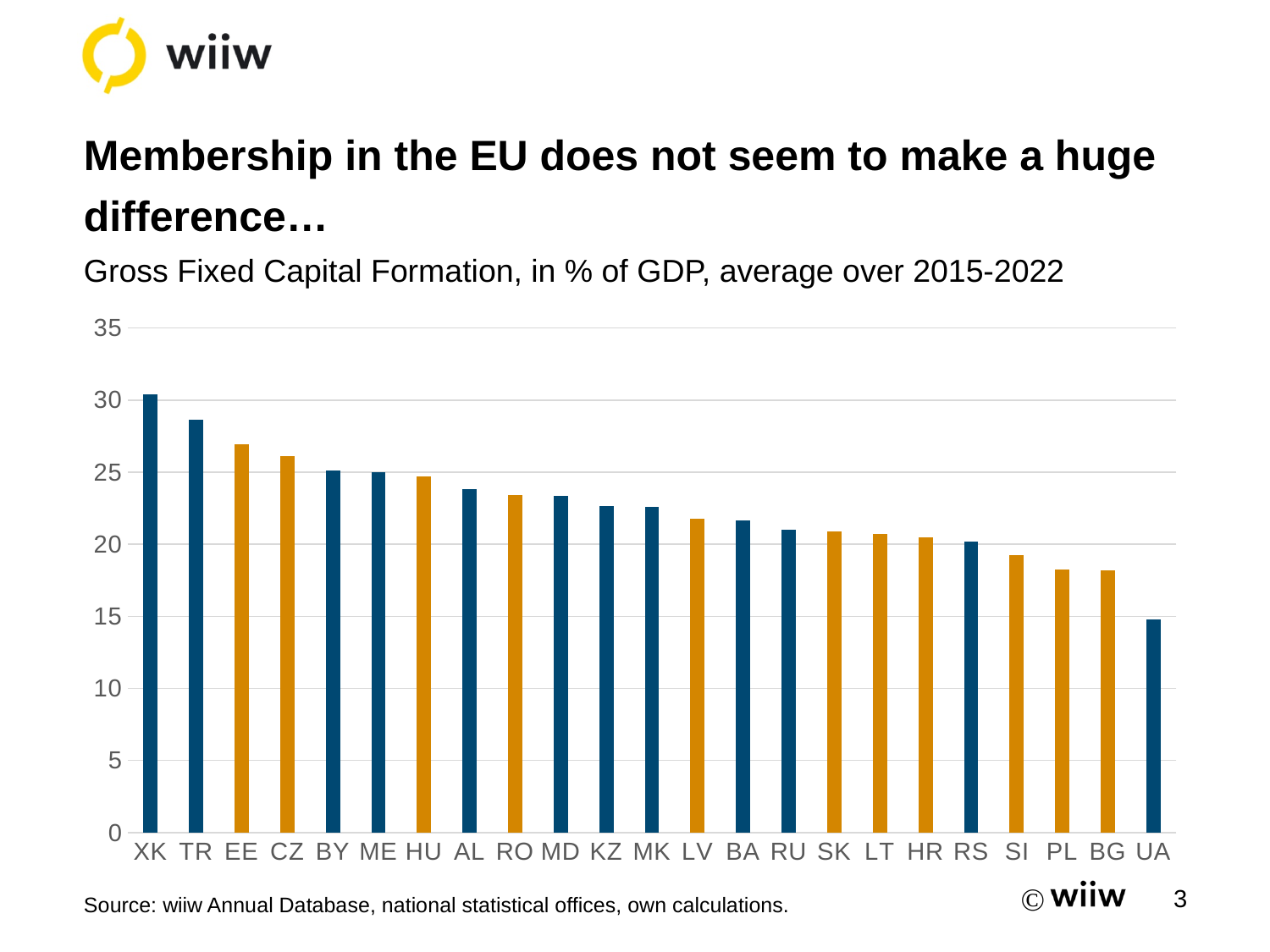
Which country has the highest Gross Fixed Capital Formation in % of GDP? XK What is the chart's subtitle describing the plotted indicator? Gross Fixed Capital Formation, in % of GDP, average over 2015-2022 Is the value for SI greater or less than 20? less Which country has the lowest Gross Fixed Capital Formation in % of GDP? UA Is the value for UA greater or less than 20? less Which has a higher value, XK or TR? XK Do the values rise or fall moving from left to right along the x axis? Fall Is the value for AL greater or less than 25? less What kind of chart is shown on the slide? Bar chart How many countries are shown on the x axis of the chart? 23